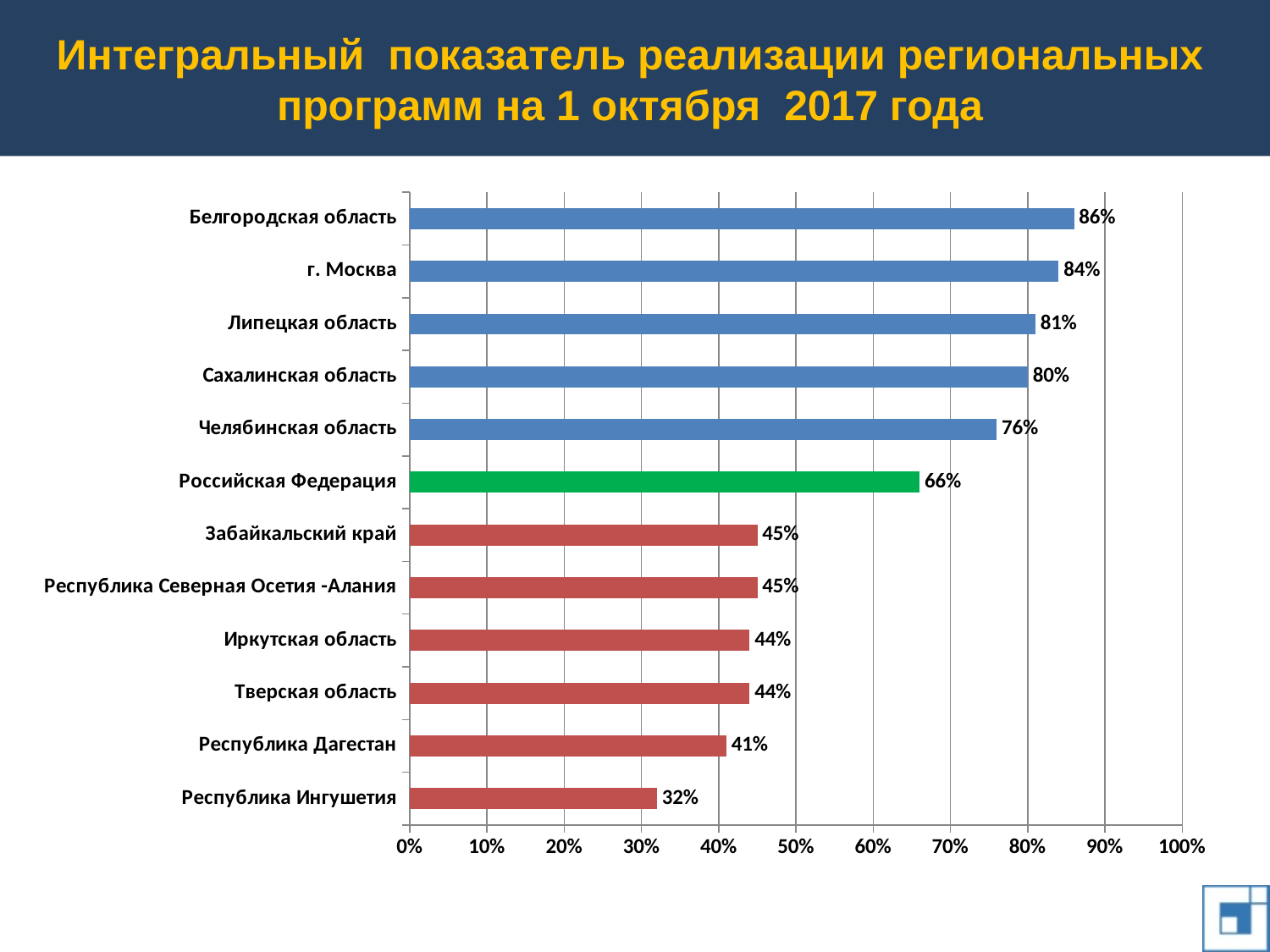
What is the difference between the values for г. Москва and Челябинская область? 8% What is the difference between the values for Российская Федерация and Республика Ингушетия? 34% Which category has the highest value? Белгородская область What is the value for Российская Федерация? 66% What is the value for Республика Дагестан? 41% Is the value for Липецкая область greater or less than 70%? greater What kind of chart is shown on the slide? bar chart Which category has the lowest value? Республика Ингушетия What colour is the bar for Российская Федерация? green What is the value for Белгородская область? 86% Which is larger, the value for Сахалинская область or the value for Забайкальский край? Сахалинская область How many categories are shown on the chart? 12